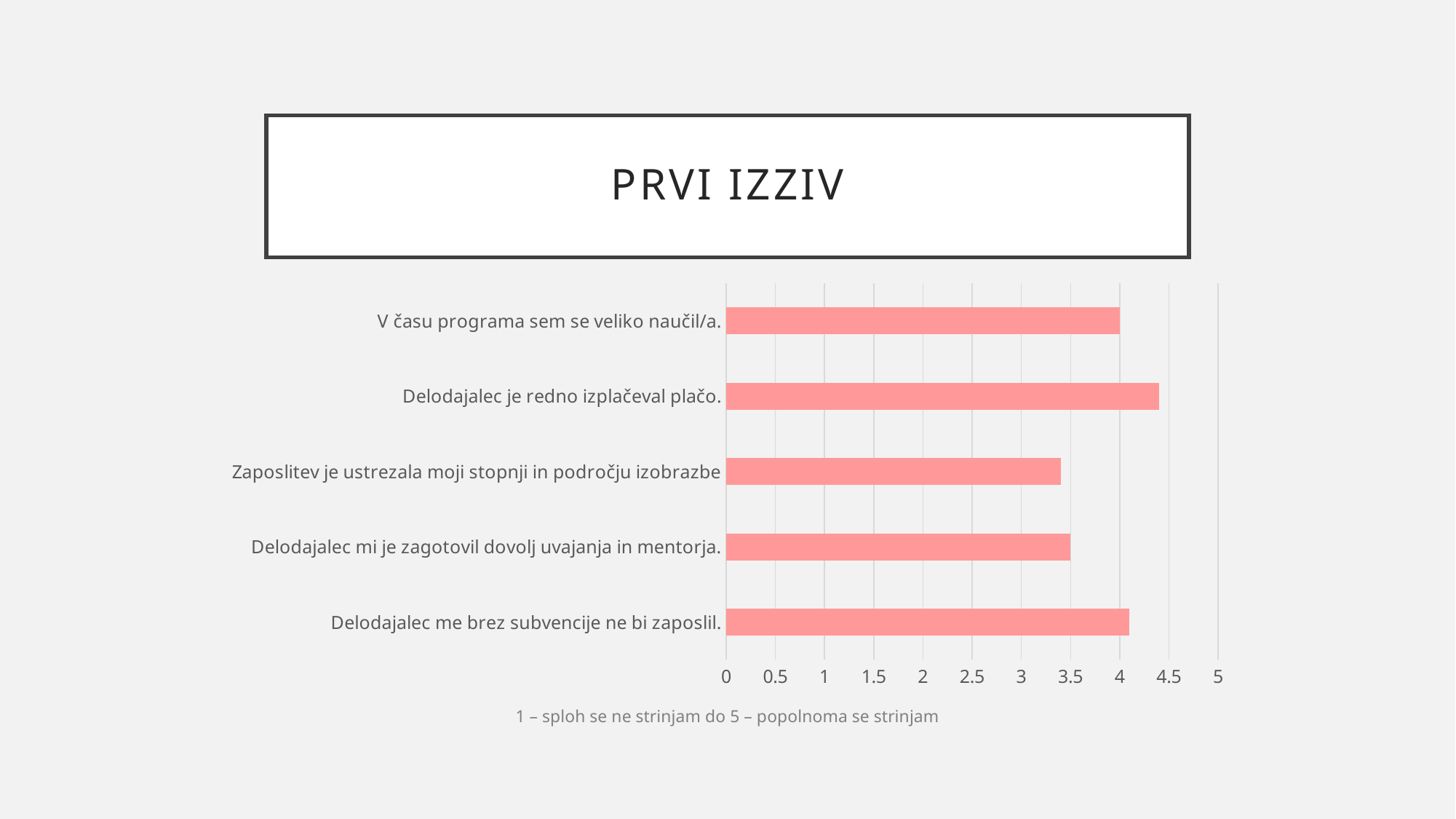
Is the value for "Zaposlitev je ustrezala moji stopnji in področju izobrazbe" greater or less than 3.5? less What is the value for "Delodajalec mi je zagotovil dovolj uvajanja in mentorja."? 3.5 What is the maximum value shown on the horizontal axis? 5 How many categories (statements) are plotted in the chart? 5 Which has a larger value: "Delodajalec me brez subvencije ne bi zaposlil." or "Zaposlitev je ustrezala moji stopnji in področju izobrazbe"? Delodajalec me brez subvencije ne bi zaposlil. What is the title shown above the chart? PRVI IZZIV Which has a larger value: "Delodajalec je redno izplačeval plačo." or "V času programa sem se veliko naučil/a."? Delodajalec je redno izplačeval plačo. Which statement has the highest value in the chart? Delodajalec je redno izplačeval plačo. Is the value for "Delodajalec je redno izplačeval plačo." greater or less than 4? greater Is the value for "Delodajalec me brez subvencije ne bi zaposlil." greater or less than 4.5? less What kind of chart is shown on the slide? bar chart What is the value for "V času programa sem se veliko naučil/a."? 4